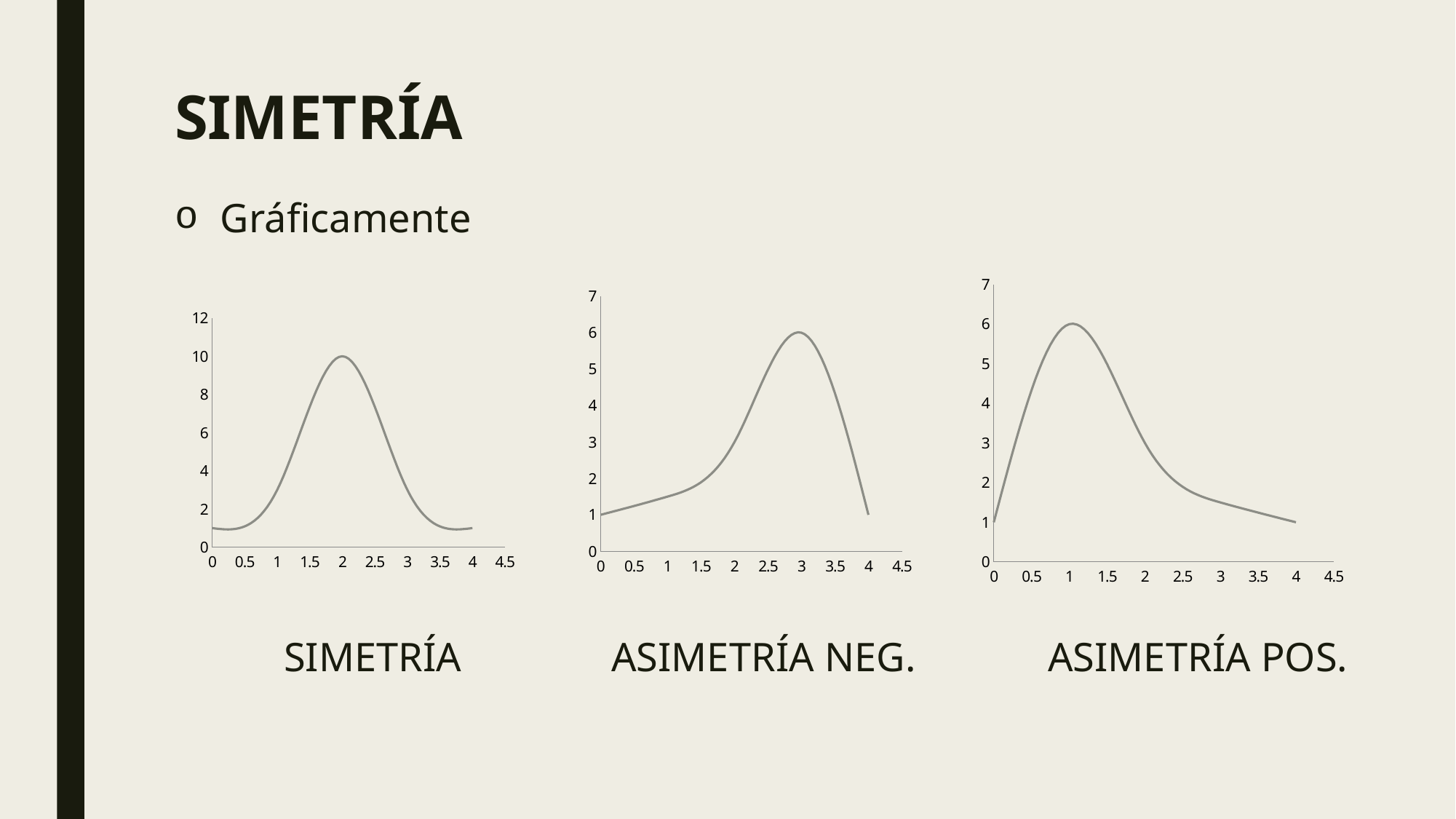
In the ASIMETRÍA NEG. chart, is the value at x = 2.5 greater or less than 4? greater In the ASIMETRÍA NEG. chart, at which x value does the curve reach its peak? 3 In the ASIMETRÍA POS. chart, at which x value does the curve reach its peak? 1 In the ASIMETRÍA NEG. chart, does the curve rise or fall between x = 0 and x = 3? rise In the ASIMETRÍA NEG. chart, what is the peak value of the curve? 6 In the SIMETRÍA chart, what is the peak value of the curve? 10 In the ASIMETRÍA POS. chart, is the value at x = 2.5 greater or less than 3? less What is the maximum value shown on the y axis of the SIMETRÍA chart? 12 In the ASIMETRÍA POS. chart, does the curve rise or fall between x = 1 and x = 4? fall What kind of chart is the SIMETRÍA chart? line chart How many charts are shown on the slide? 3 In the SIMETRÍA chart, at which x value does the curve reach its peak? 2